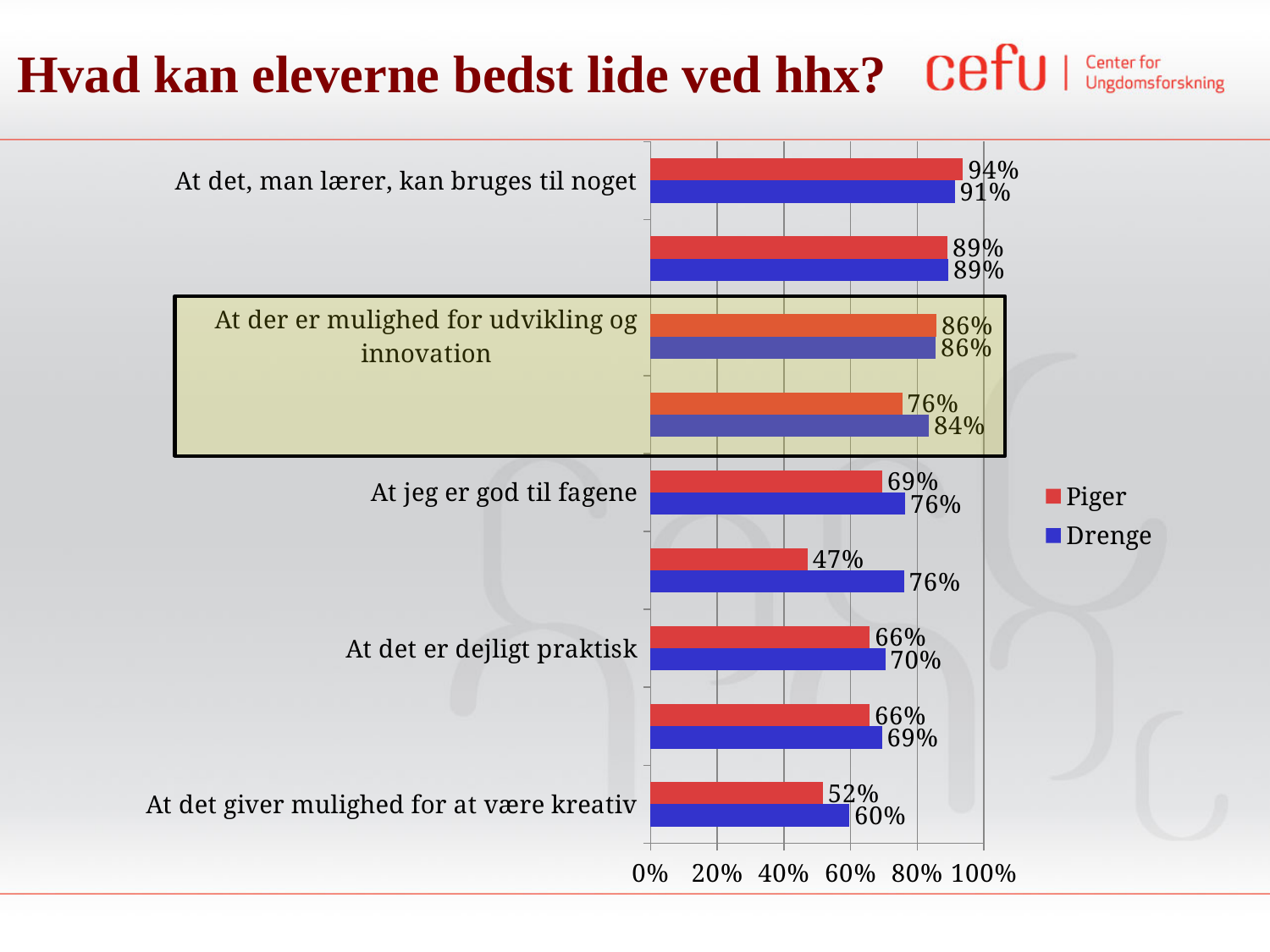
What kind of chart is shown on the slide? bar chart For "At det giver mulighed for at være kreativ", which is larger, the Piger value or the Drenge value? Drenge Which category has the lowest Drenge value? At det giver mulighed for at være kreativ What are the two series named in the legend? Piger and Drenge Which category has the highest Piger value? At det, man lærer, kan bruges til noget What is the Drenge value for "At jeg er god til fagene"? 76% What is the Piger value for "At det, man lærer, kan bruges til noget"? 94% What is the Drenge value for "At det, man lærer, kan bruges til noget"? 91% What is the Piger value for "At det giver mulighed for at være kreativ"? 52% What is the difference between the Drenge and Piger values for "At jeg er god til fagene"? 7% How many series does the legend list? 2 What is the Drenge value for "At det er dejligt praktisk"? 70%